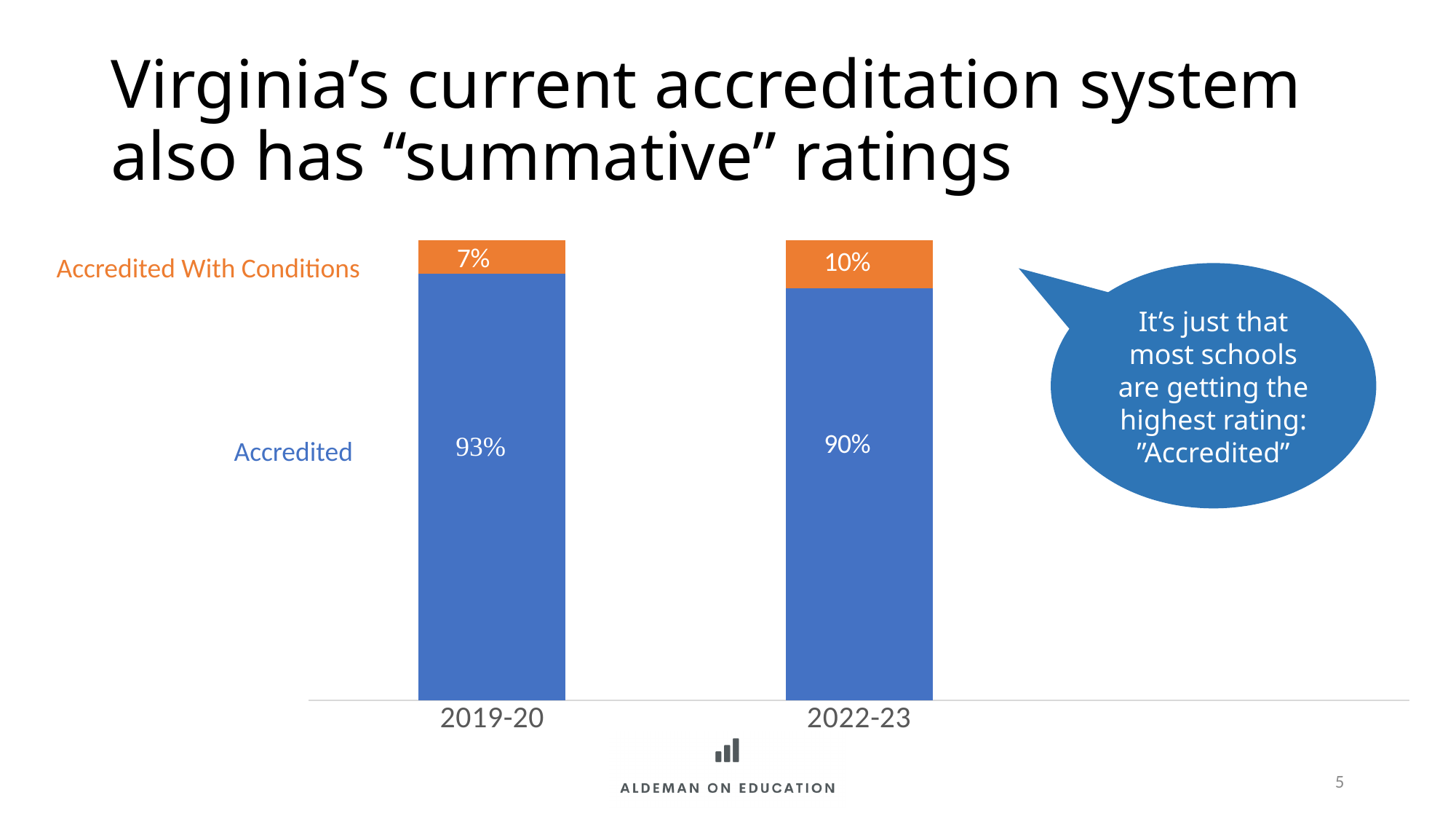
What is the total of the stacked bar for 2019-20? 100% By how many percentage points did the Accredited With Conditions share rise from 2019-20 to 2022-23? 3 percentage points In which year was the Accredited With Conditions share higher? 2022-23 How many years (categories) are shown on the x axis? 2 In which year was the Accredited share higher? 2019-20 What percentage of schools were Accredited With Conditions in 2019-20? 7% By how many percentage points did the Accredited share fall from 2019-20 to 2022-23? 3 percentage points What percentage of schools were Accredited in 2022-23? 90% What percentage of schools were Accredited With Conditions in 2022-23? 10% What kind of chart is shown on the slide? Stacked bar chart What percentage of schools were Accredited in 2019-20? 93% How many series does the chart show? 2